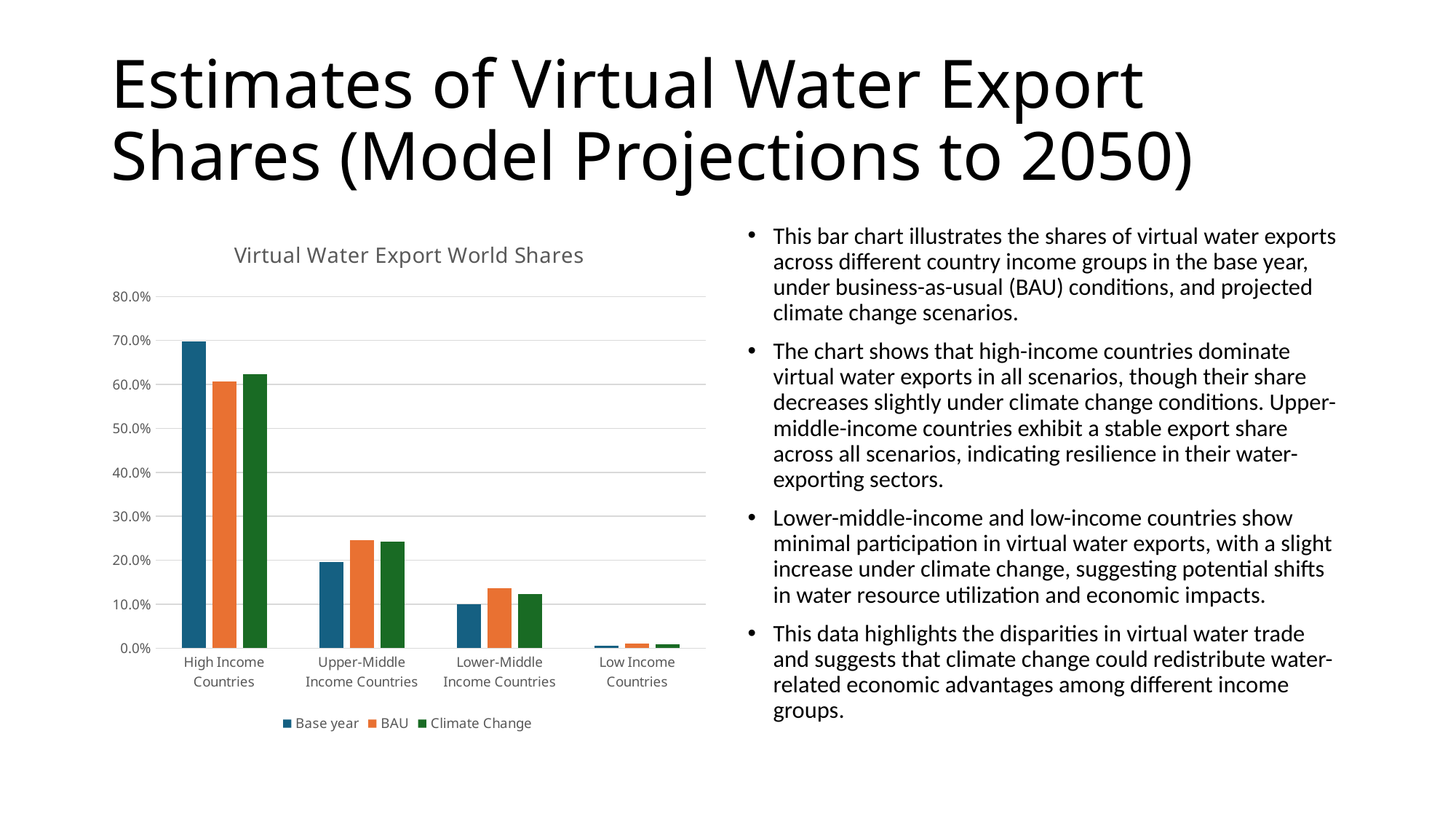
Which country income group has the highest Base year share? High Income Countries Which country income group has the lowest Climate Change share? Low Income Countries How many series does the chart legend list? 3 Is the BAU value for High Income Countries greater or less than 70.0%? less For High Income Countries, which is larger: the Base year value or the BAU value? Base year How many country income groups are shown on the x axis? 4 Do the Base year values rise or fall moving from High Income Countries to Low Income Countries along the x axis? fall Is the BAU value for Lower-Middle Income Countries greater or less than 10.0%? greater What is the title of the chart? Virtual Water Export World Shares What type of chart is shown on the slide? Bar chart Is the Base year value for High Income Countries greater or less than 60.0%? greater